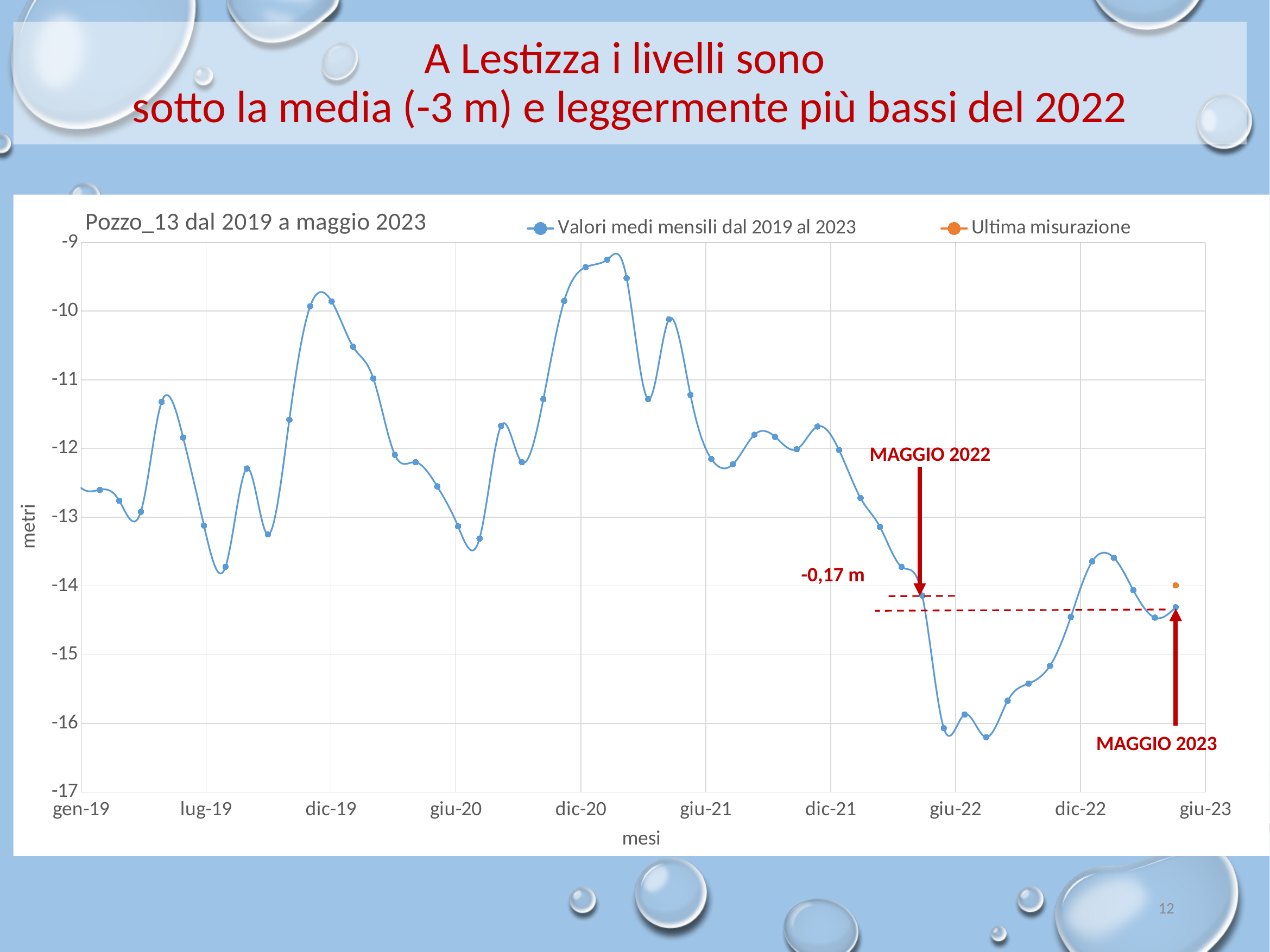
What is the title of the chart? Pozzo_13 dal 2019 a maggio 2023 How many labels are shown on the horizontal axis of the chart? 10 Which is higher on the chart, the level at MAGGIO 2022 or the level at MAGGIO 2023? MAGGIO 2022 Is the value of the monthly series at dic-20 greater or less than -10? greater What difference is annotated on the chart between MAGGIO 2022 and MAGGIO 2023? -0,17 m What is the label of the vertical axis of the chart? metri Between dic-21 and giu-22, does the monthly series rise or fall? fall Between which two x-axis labels does the monthly series reach its lowest value? giu-22 and dic-22 How many series does the chart legend list? 2 Is the value of the monthly series at gen-19 greater or less than -13? greater What kind of chart is shown on the slide? line chart Is the value of the monthly series at lug-19 greater or less than -12? less